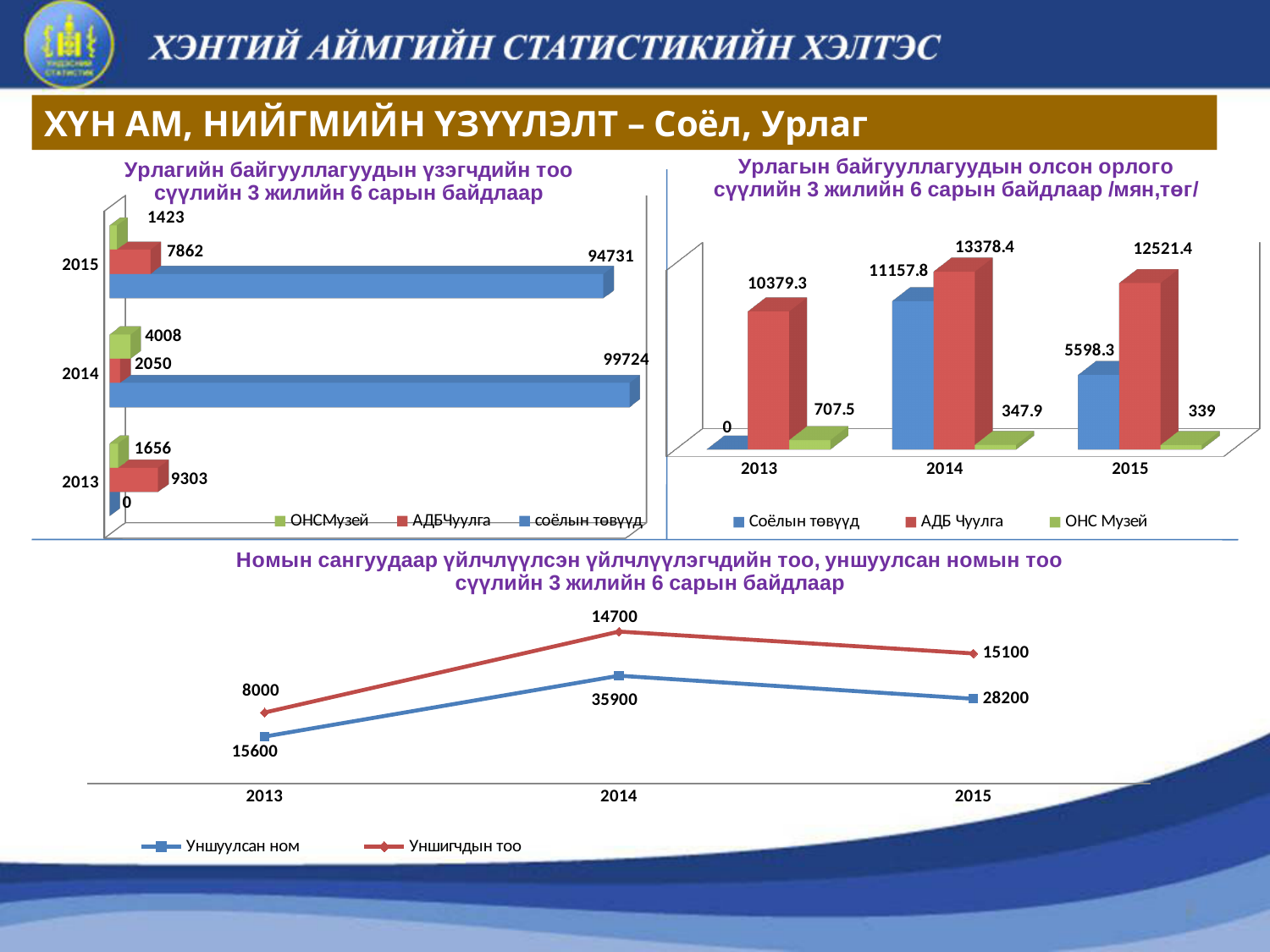
In the bottom line chart about library users and books, what is the value for Уншуулсан ном in 2014? 35900 In the chart titled 'Урлагын байгууллагуудын олсон орлого', what is the value for Соёлын төвүүд in 2015? 5598.3 In the bottom line chart about library users and books, does the value for Уншигчдын тоо rise or fall from 2013 to 2015? Rise In the chart titled 'Урлагийн байгууллагуудын үзэгчдийн тоо', what is the value for соёлын төвүүд in 2015? 94731 In the bottom line chart about library users and books, what is the difference between the Уншигчдын тоо values for 2015 and 2013? 7100 In the chart titled 'Урлагийн байгууллагуудын үзэгчдийн тоо', what is the difference between the соёлын төвүүд values for 2014 and 2015? 4993 In the chart titled 'Урлагын байгууллагуудын олсон орлого', what is the value for АДБ Чуулга in 2014? 13378.4 In the chart titled 'Урлагийн байгууллагуудын үзэгчдийн тоо', which year has the highest value for ОНСМузей? 2014 In the chart titled 'Урлагийн байгууллагуудын үзэгчдийн тоо', what is the value for АДБЧуулга in 2013? 9303 In the chart titled 'Урлагын байгууллагуудын олсон орлого', how many series does the legend list? 3 What type of chart is the top-left chart titled 'Урлагийн байгууллагуудын үзэгчдийн тоо'? Bar chart In the chart titled 'Урлагын байгууллагуудын олсон орлого', which year has the lowest value for ОНС Музей? 2015